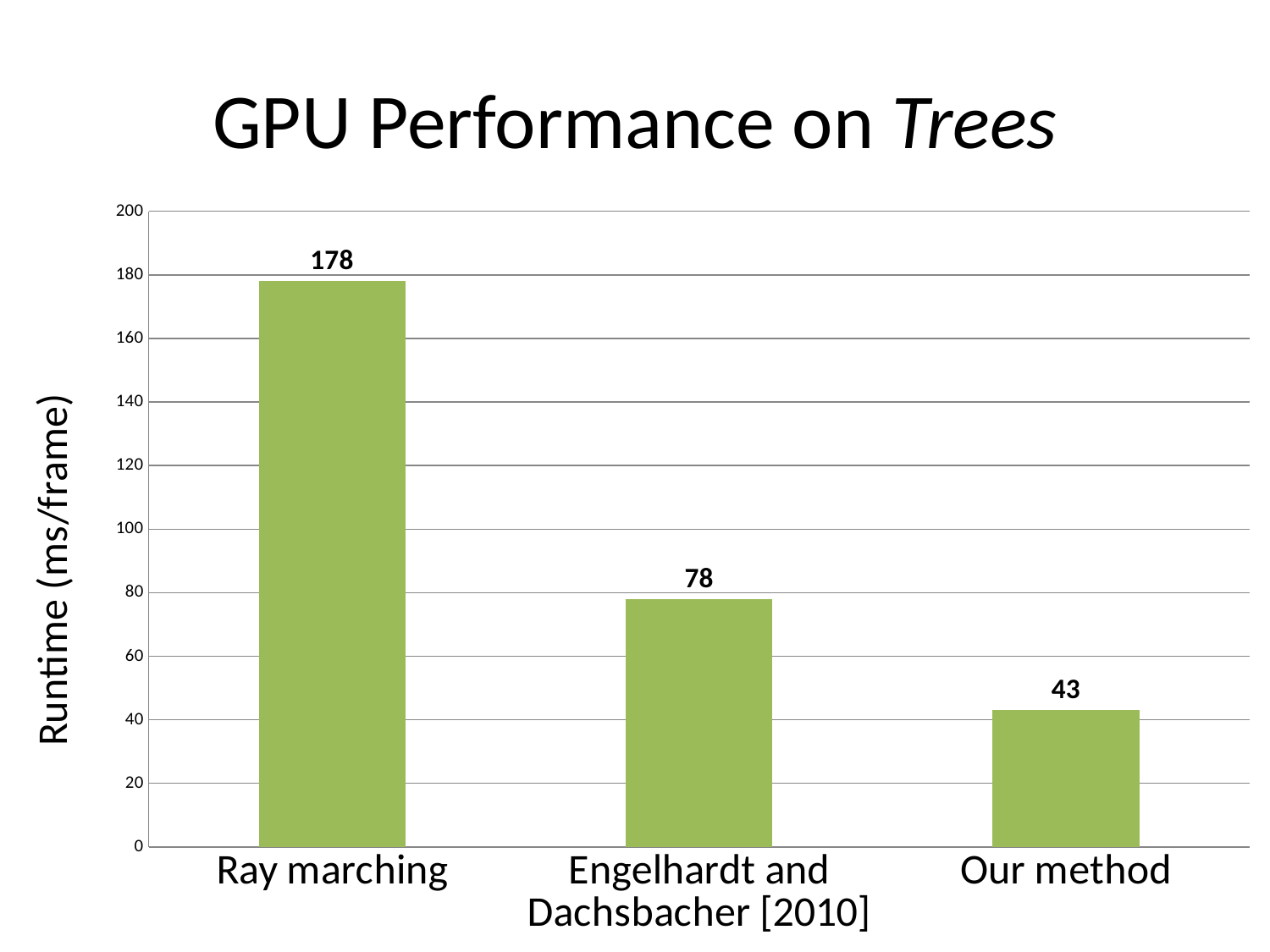
What is the runtime for Our method? 43 What is the label of the vertical axis? Runtime (ms/frame) Which has a larger runtime, Ray marching or Engelhardt and Dachsbacher [2010]? Ray marching How many methods are compared in the chart? 3 Which method has the highest runtime? Ray marching What is the runtime for Ray marching? 178 Is the value for Our method greater or less than 60? less What kind of chart is shown on the slide? bar chart What is the runtime for Engelhardt and Dachsbacher [2010]? 78 Which method has the lowest runtime? Our method What is the difference in runtime between Engelhardt and Dachsbacher [2010] and Our method? 35 What is the difference in runtime between Ray marching and Our method? 135